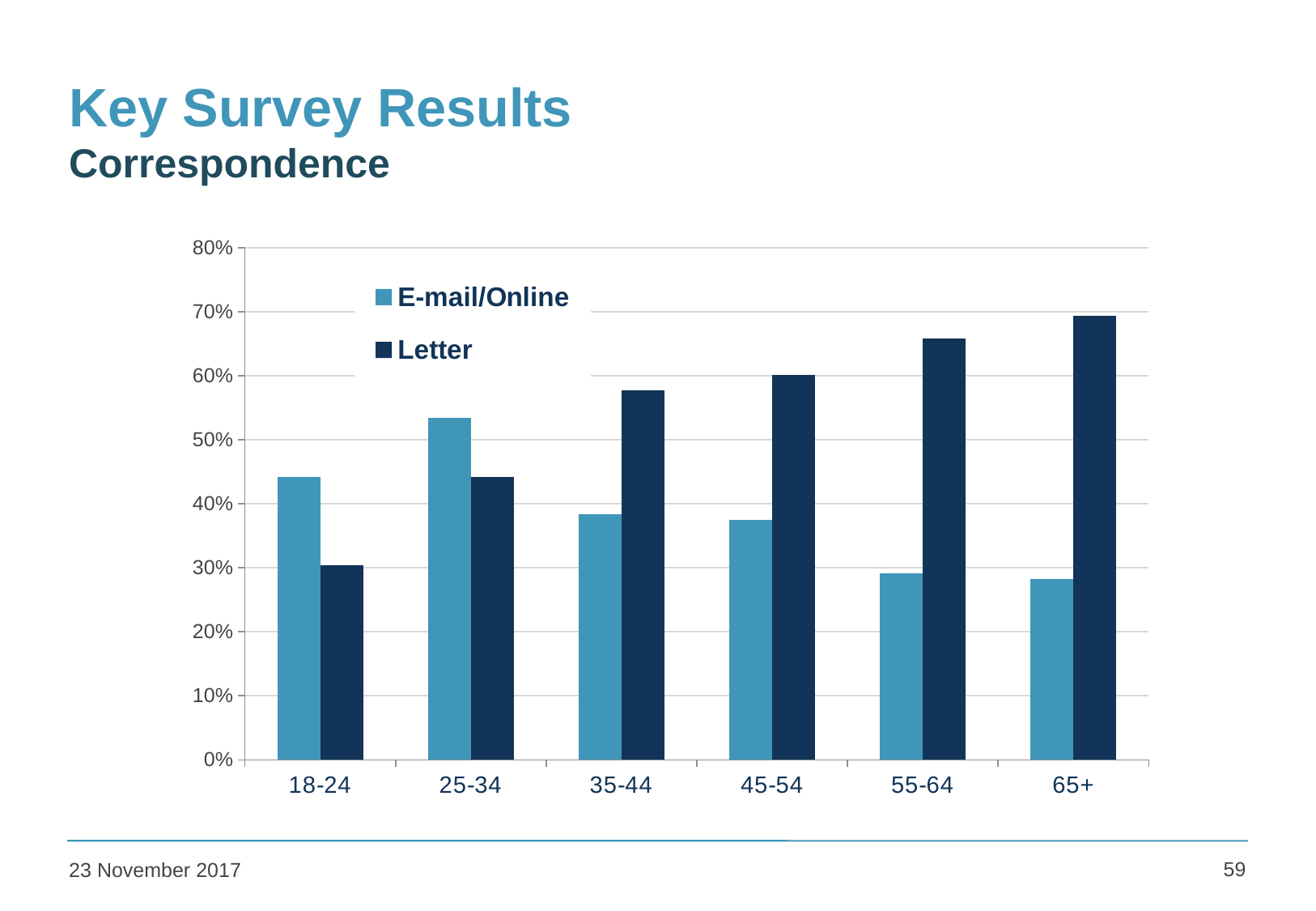
Is the Letter value for 65+ greater or less than 60%? greater How many series does the legend list? 2 Which age group has the highest E-mail/Online value? 25-34 Which age group has the lowest Letter value? 18-24 Do the Letter values rise or fall as the age groups increase along the x axis? rise Is the E-mail/Online value for 25-34 greater or less than 50%? greater What kind of chart is shown on the slide? bar chart Is the Letter value for 18-24 greater or less than 40%? less Which age group has the highest Letter value? 65+ How many age groups are shown on the x axis? 6 For the 65+ age group, which is larger: E-mail/Online or Letter? Letter For the 18-24 age group, which is larger: E-mail/Online or Letter? E-mail/Online